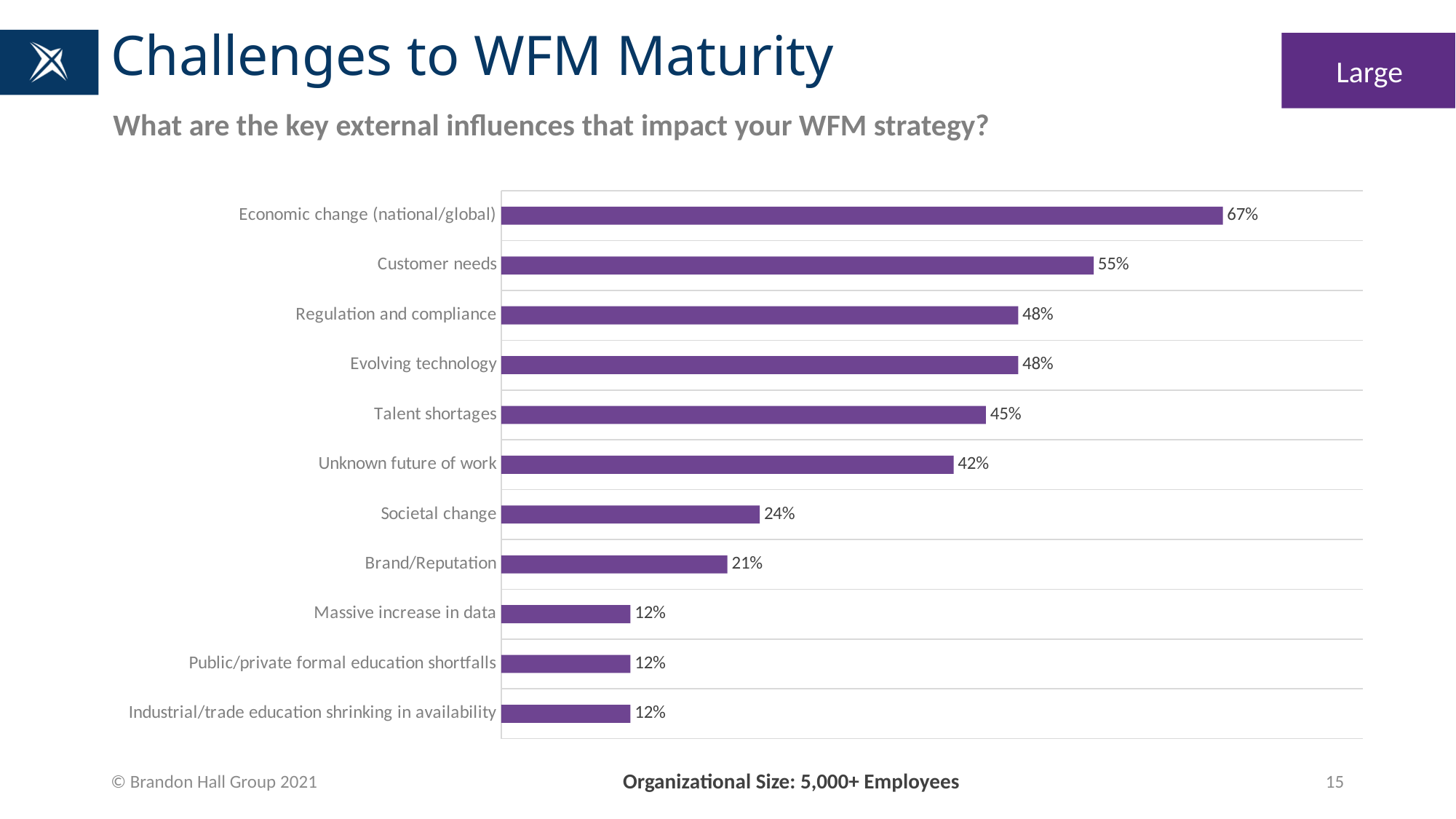
What organizational size does the chart cover, according to the footer? 5,000+ Employees What kind of chart is shown on the slide? Bar chart What is the difference between Unknown future of work and Societal change? 18% What percentage is shown for Economic change (national/global)? 67% What is the difference between Economic change (national/global) and Customer needs? 12% What is the value for Customer needs? 55% How many categories share the lowest value of 12%? 3 What percentage is shown for Talent shortages? 45% How many categories are shown in the chart? 11 Which category has the highest value? Economic change (national/global) What is the value for Societal change? 24% Which is larger, Brand/Reputation or Massive increase in data? Brand/Reputation